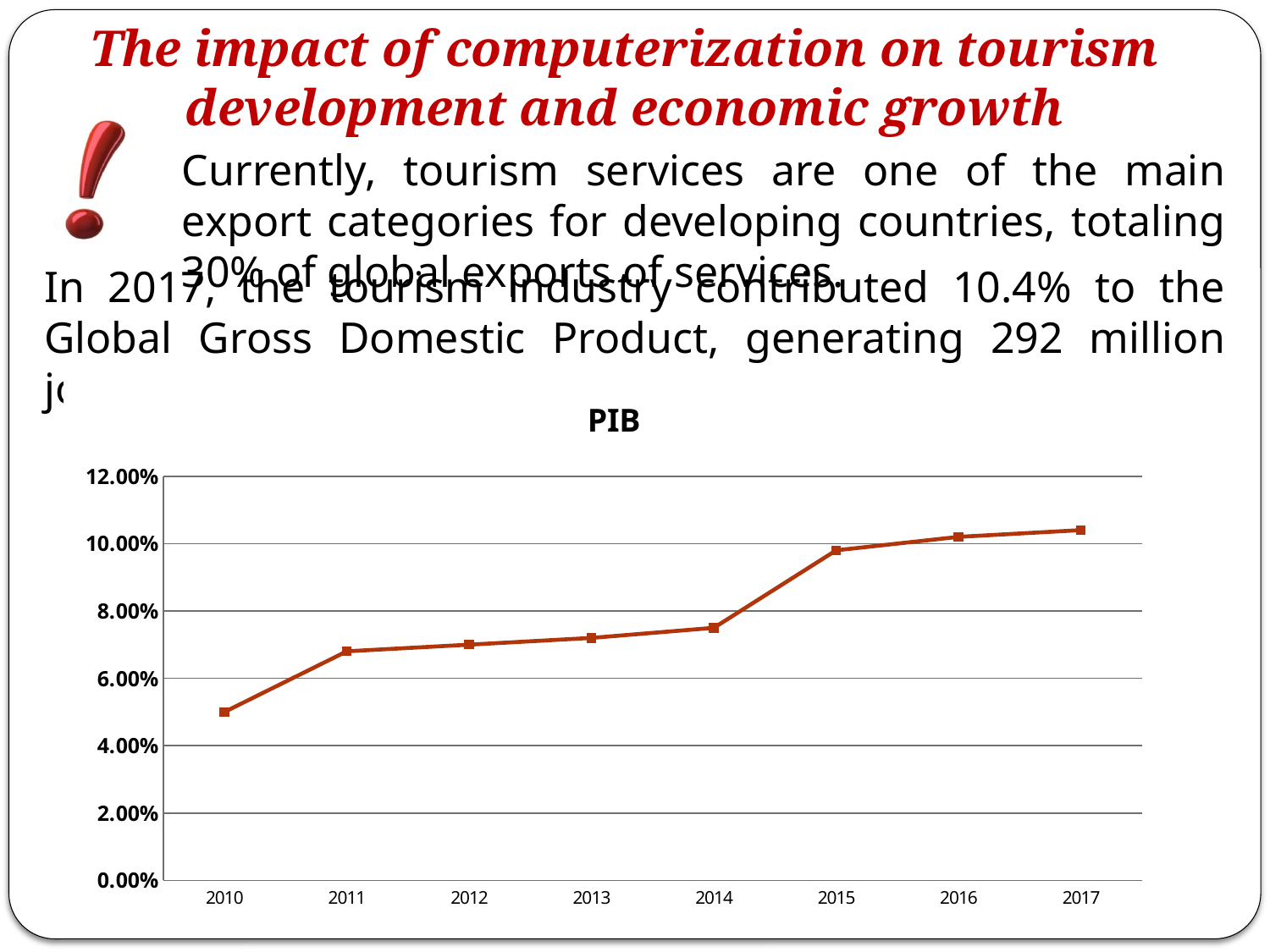
What kind of chart is shown on the slide? line chart How many years are plotted on the x axis of the chart? 8 Do the values in the chart rise or fall from 2010 to 2017? rise What is the title of the chart? PIB Is the value for 2010 greater or less than 6.00%? less Is the value for 2015 greater or less than 8.00%? greater Is the value for 2014 greater or less than 8.00%? less Which year has the highest value in the chart? 2017 Which is larger, the value for 2011 or the value for 2015? 2015 Which year has the lowest value in the chart? 2010 What is the first year shown on the x axis of the chart? 2010